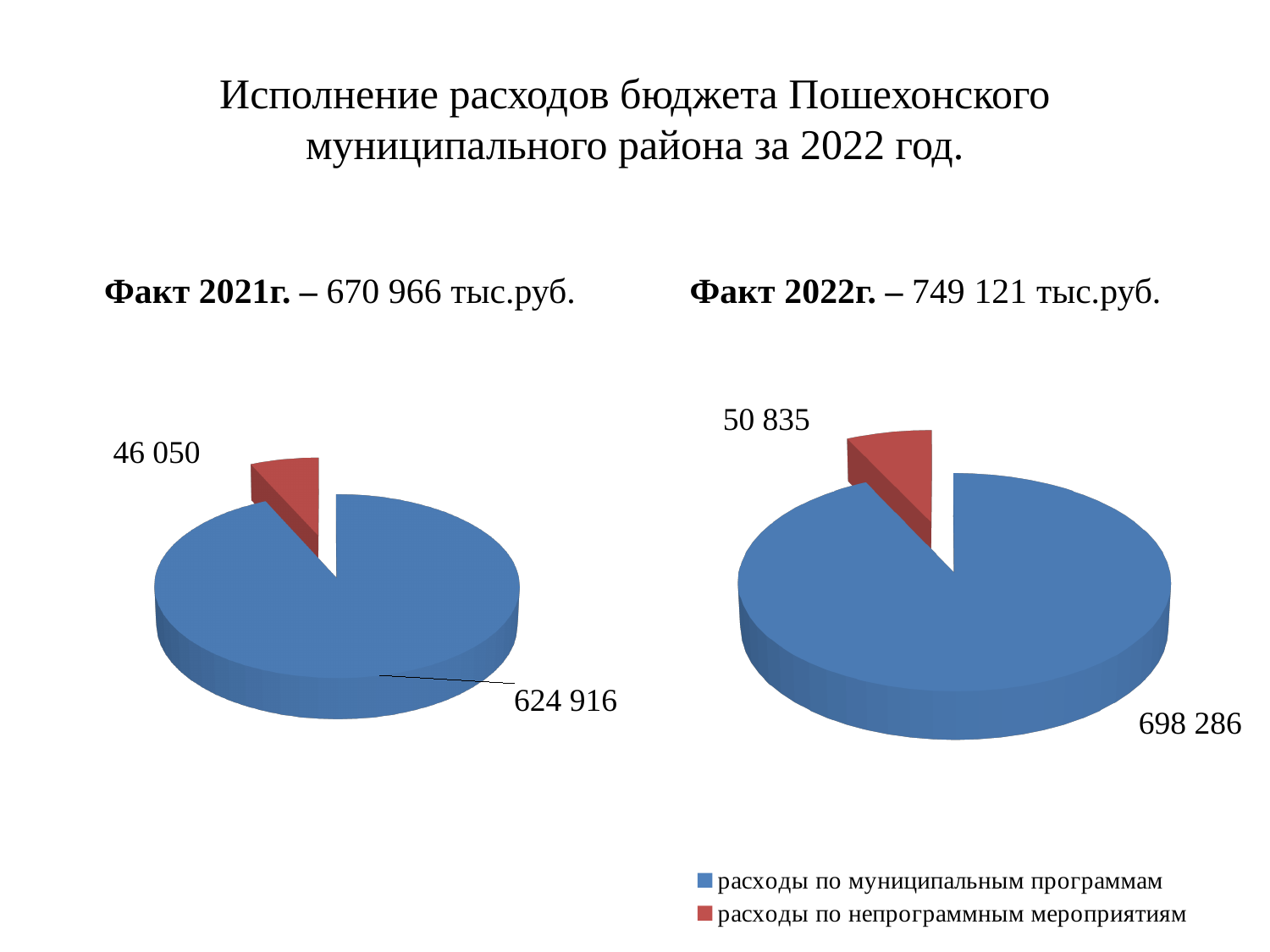
In the 2021 pie chart (left), what is the value for расходы по муниципальным программам? 624 916 In the 2021 pie chart (left), which category has the smallest slice? расходы по непрограммным мероприятиям In the 2021 pie chart (left), what is the total of the two slices? 670 966 What is the difference between the value for расходы по муниципальным программам in the 2022 chart and in the 2021 chart? 73 370 What is the difference between the value for расходы по непрограммным мероприятиям in the 2022 chart and in the 2021 chart? 4 785 How many series does the legend list? 2 In the 2022 pie chart (right), which category has the largest slice? расходы по муниципальным программам In the 2021 pie chart (left), what is the value for расходы по непрограммным мероприятиям? 46 050 In the 2022 pie chart (right), what is the value for расходы по непрограммным мероприятиям? 50 835 Which is larger: расходы по непрограммным мероприятиям in the 2021 chart or in the 2022 chart? 2022 chart In the 2022 pie chart (right), what is the value for расходы по муниципальным программам? 698 286 What type of chart is used on this slide? Pie chart